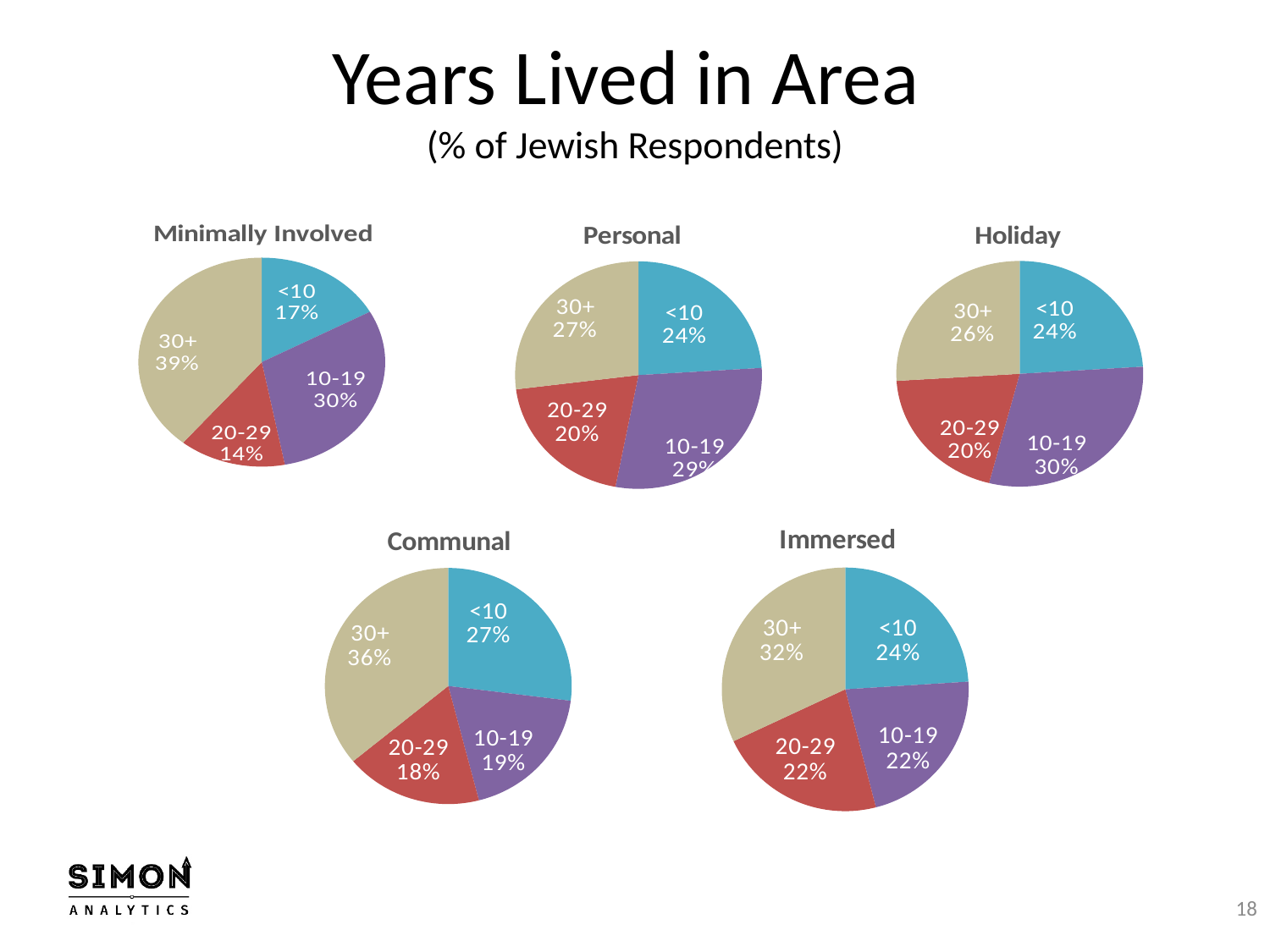
What type of chart is used for the Personal group? Pie chart How many pie charts are shown on the slide? 5 In the Communal chart, which category has the largest share? 30+ In the Communal chart, what percentage of respondents have lived in the area 10-19 years? 19% In the Immersed chart, which is larger, the <10 slice or the 20-29 slice? <10 In the Minimally Involved chart, what share of respondents have lived in the area 30+ years? 39% In the Holiday chart, what is the value for the <10 slice? 24% In the Personal chart, what percentage of respondents have lived in the area 20-29 years? 20% In the Immersed chart, what is the value for the 30+ slice? 32% How many slices does the Holiday pie chart have? 4 In the Minimally Involved chart, what is the difference between the 30+ share and the <10 share? 22% In the Minimally Involved chart, which category has the smallest share? 20-29